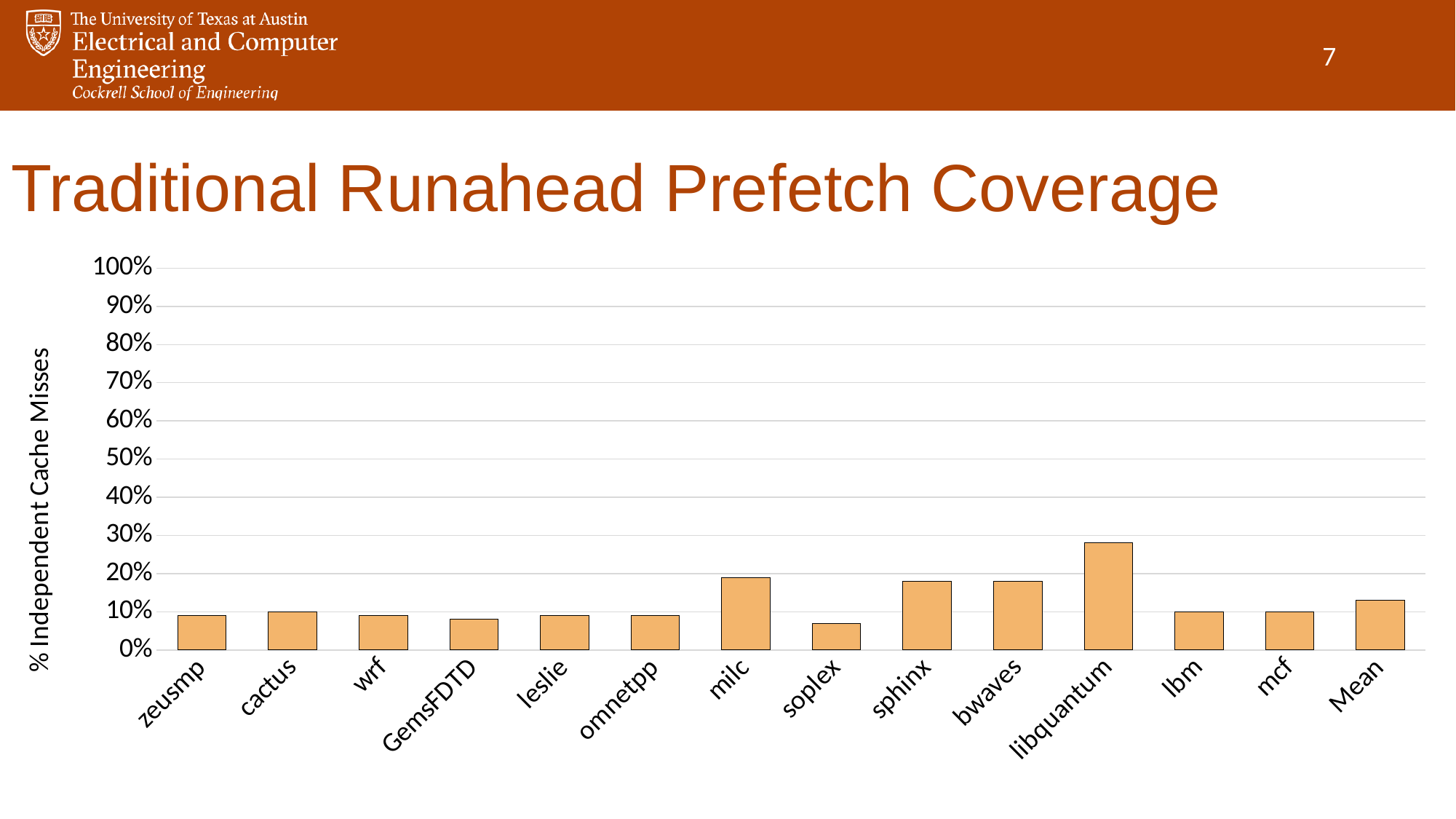
What is the label on the y axis of the chart? % Independent Cache Misses How many categories are shown along the x axis of the chart? 14 What kind of chart is shown on the slide? bar chart Is the value for sphinx greater or less than 10%? greater What is the title of the slide containing the chart? Traditional Runahead Prefetch Coverage Which is larger, the value for milc or the value for soplex? milc Is the value for Mean greater or less than 10%? greater Which is larger, the value for libquantum or the value for milc? libquantum Which category has the highest value in the chart? libquantum Is the value for libquantum greater or less than 20%? greater